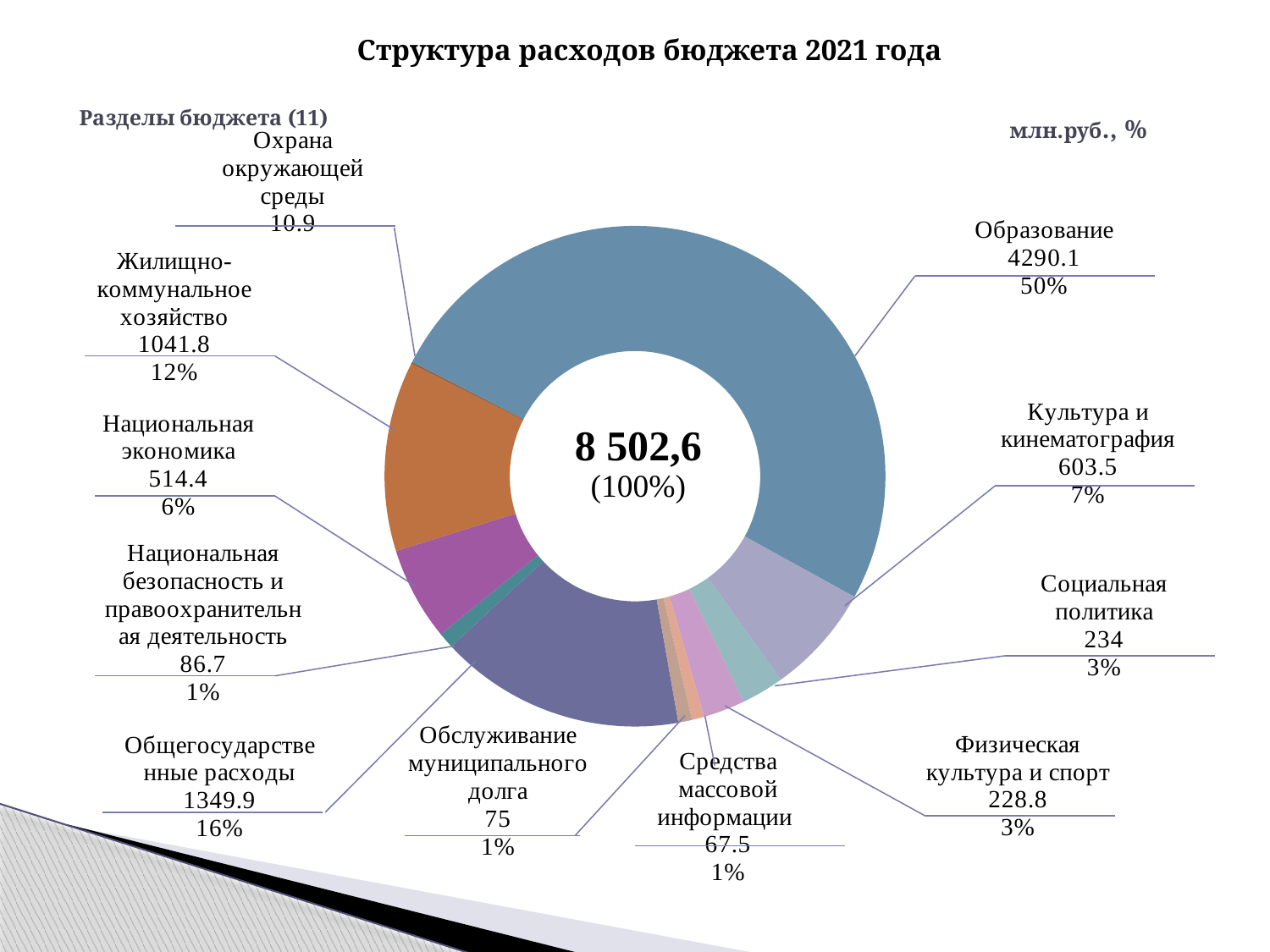
What share of the budget does Общегосударственные расходы account for? 16% Which budget section has the smallest value? Охрана окружающей среды What kind of chart is shown on the slide? Doughnut chart What is the difference between the values for Образование and Общегосударственные расходы? 2940.2 How many budget sections are shown in the chart? 11 What total value is shown in the centre of the chart? 8 502,6 What is the value for Образование? 4290.1 What is the title of the chart? Разделы бюджета (11) Which is larger, Национальная экономика or Культура и кинематография? Культура и кинематография Which budget section has the largest share? Образование What share of the budget does Социальная политика account for? 3% What is the value for Жилищно-коммунальное хозяйство? 1041.8